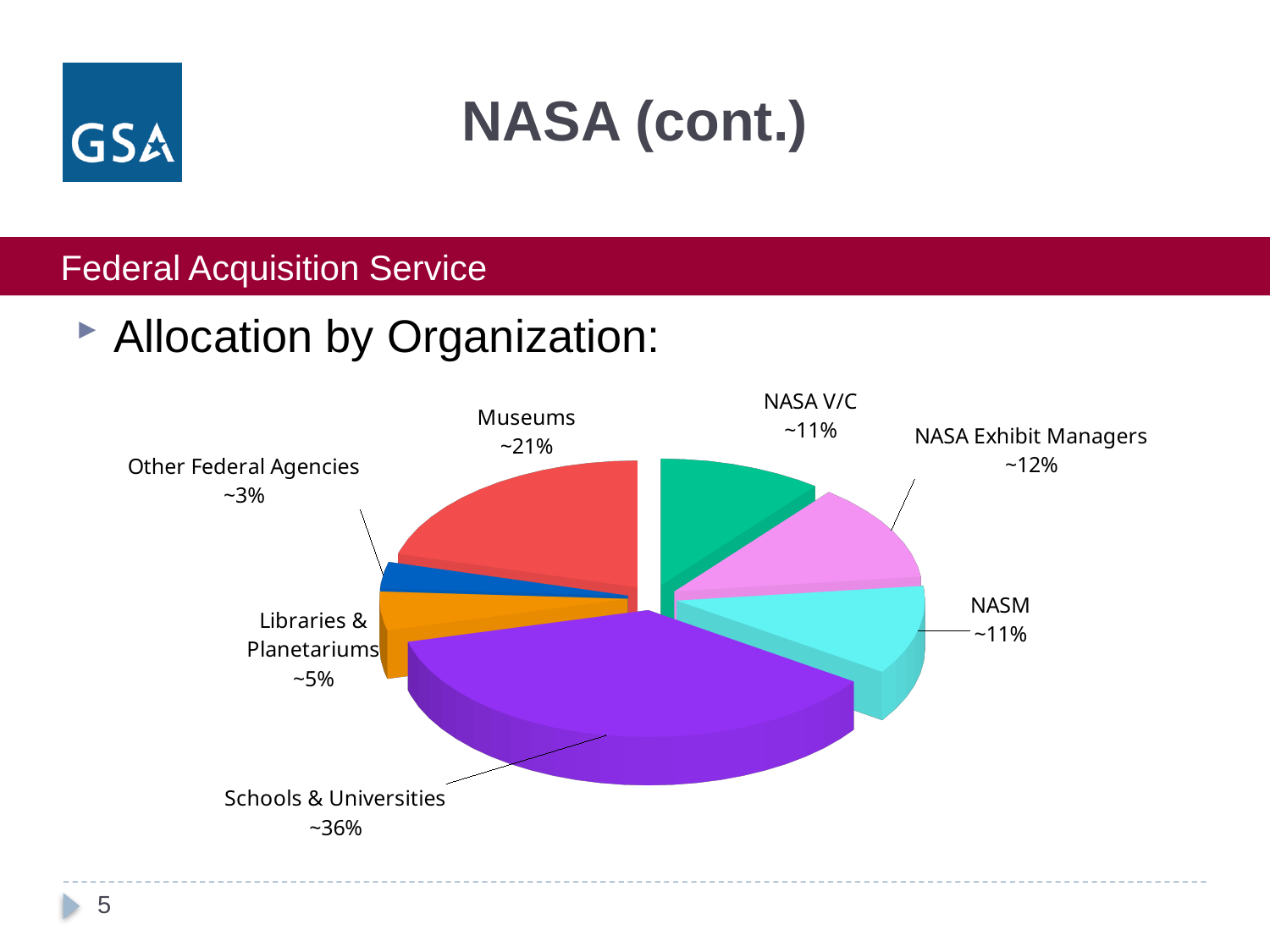
What value is shown for Other Federal Agencies? ~3% What kind of chart is shown on the slide? pie chart What share of the pie is labelled for Schools & Universities? ~36% How many slices does the pie chart have? 7 Which organization has the largest slice of the pie? Schools & Universities What value is shown for Museums? ~21% What value is shown for NASA Exhibit Managers? ~12% What value is shown for Libraries & Planetariums? ~5% What value is shown for NASM? ~11% Which is larger, the share for Museums or the share for NASA Exhibit Managers? Museums What colour is the Schools & Universities slice? purple Which organization has the smallest slice of the pie? Other Federal Agencies